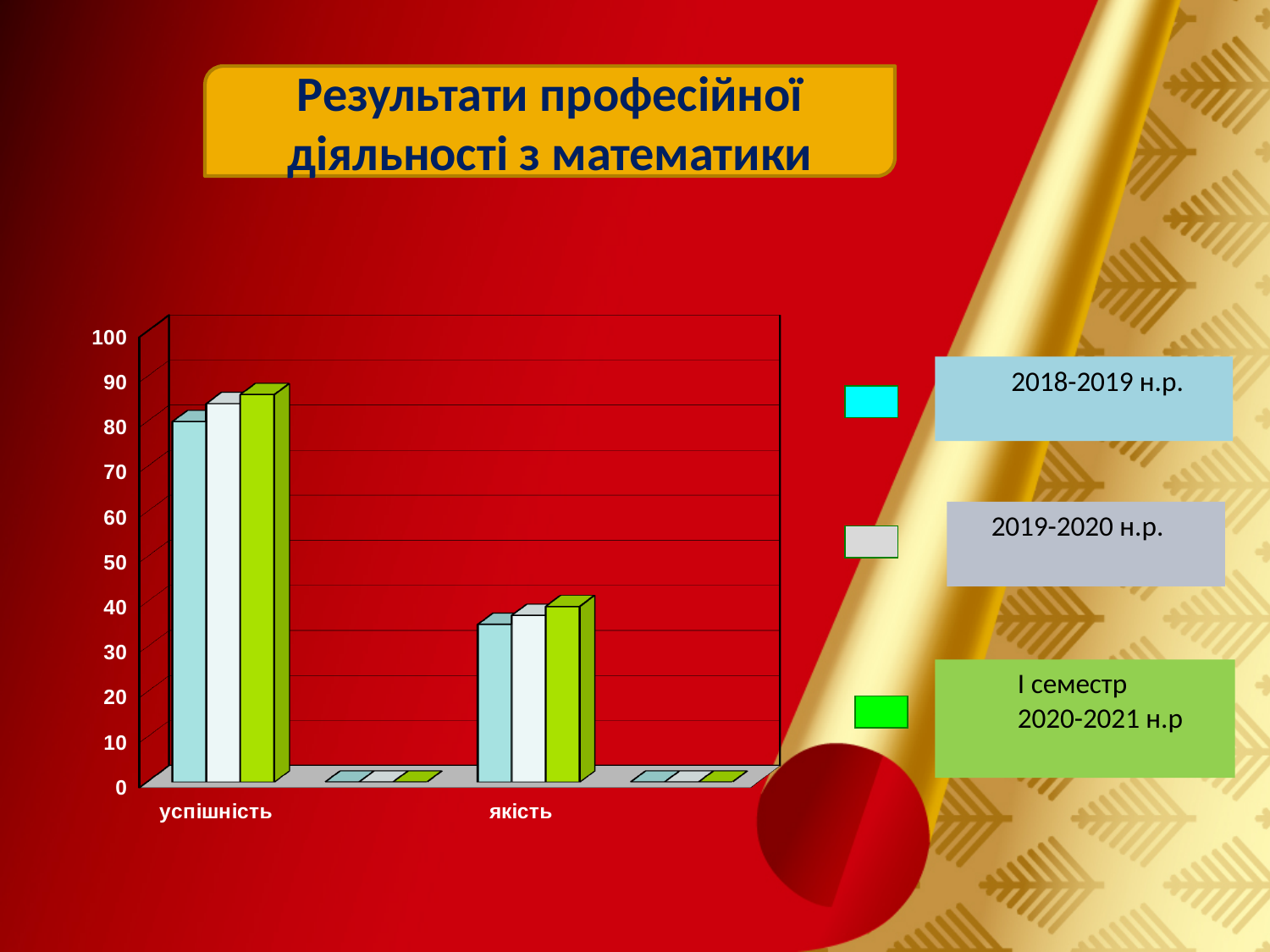
Which category has the lowest values across all series: успішність or якість? якість Is the value for успішність in 2019-2020 н.р. greater or less than 90? less Which legend entry is shown with a green colour? І семестр 2020-2021 н.р What is the title of the slide above the chart? Результати професійної діяльності з математики Which is larger for 2018-2019 н.р.: успішність or якість? успішність What kind of chart is shown on the slide? bar chart Is the value for успішність in 2018-2019 н.р. greater or less than 70? greater Is the value for якість in І семестр 2020-2021 н.р greater or less than 50? less Do the values for успішність rise or fall from 2018-2019 н.р. to І семестр 2020-2021 н.р? rise How many series does the legend list? 3